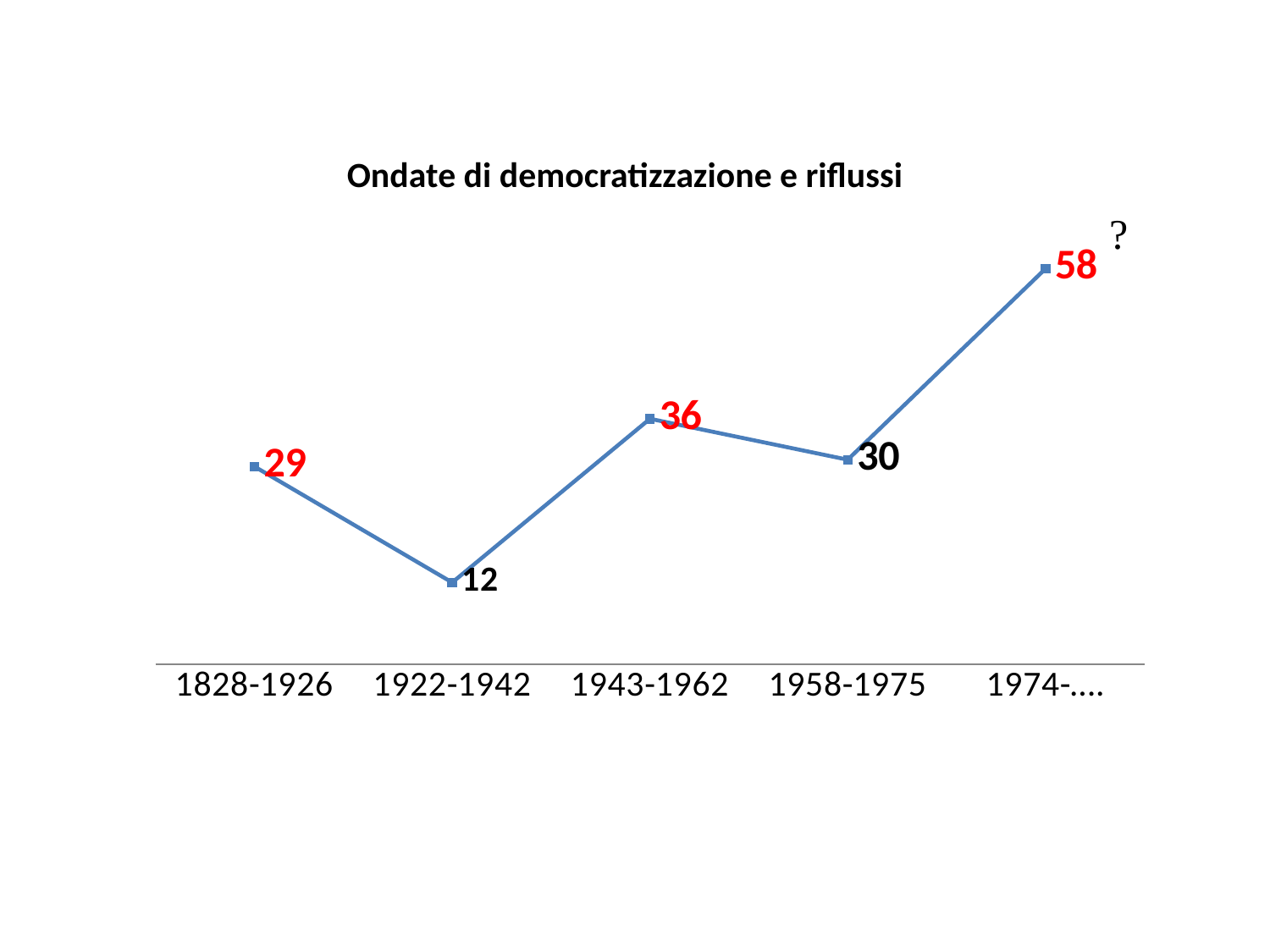
What is the title of the chart? Ondate di democratizzazione e riflussi Which is larger, the value for 1943-1962 or the value for 1958-1975? 1943-1962 Which period has the highest value? 1974-.... What kind of chart is shown on the slide? Line chart How many periods are plotted on the chart? 5 What is the value for 1922-1942? 12 What is the difference between the values for 1974-.... and 1958-1975? 28 What is the value for 1828-1926? 29 Which period has the lowest value? 1922-1942 What is the value for 1974-....? 58 What is the value for 1943-1962? 36 What is the value for 1958-1975? 30